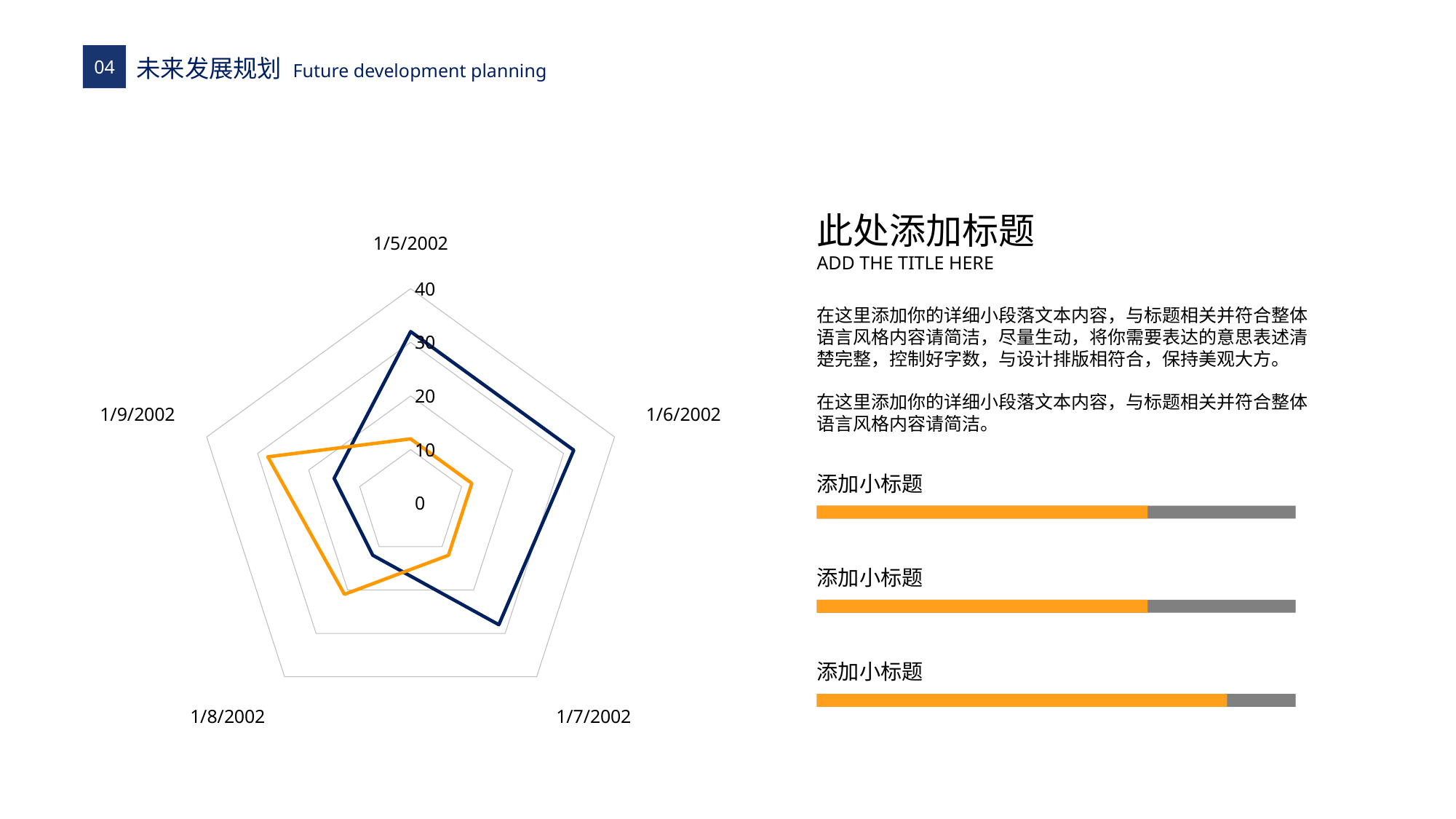
Is the dark blue series value for 1/8/2002 greater or less than 20? less How many categories (axes) does the radar chart have? 5 For which category does the orange series reach its highest value? 1/9/2002 What is the highest value shown on the radar chart's axis scale? 40 How many data series are plotted on the radar chart? 2 What kind of chart is shown on the slide? radar chart Is the orange series value for 1/9/2002 greater or less than 20? greater Is the dark blue series value for 1/5/2002 greater or less than 20? greater At 1/5/2002, which series has the larger value, the dark blue or the orange? dark blue What colours are the two series lines on the radar chart? dark blue and orange